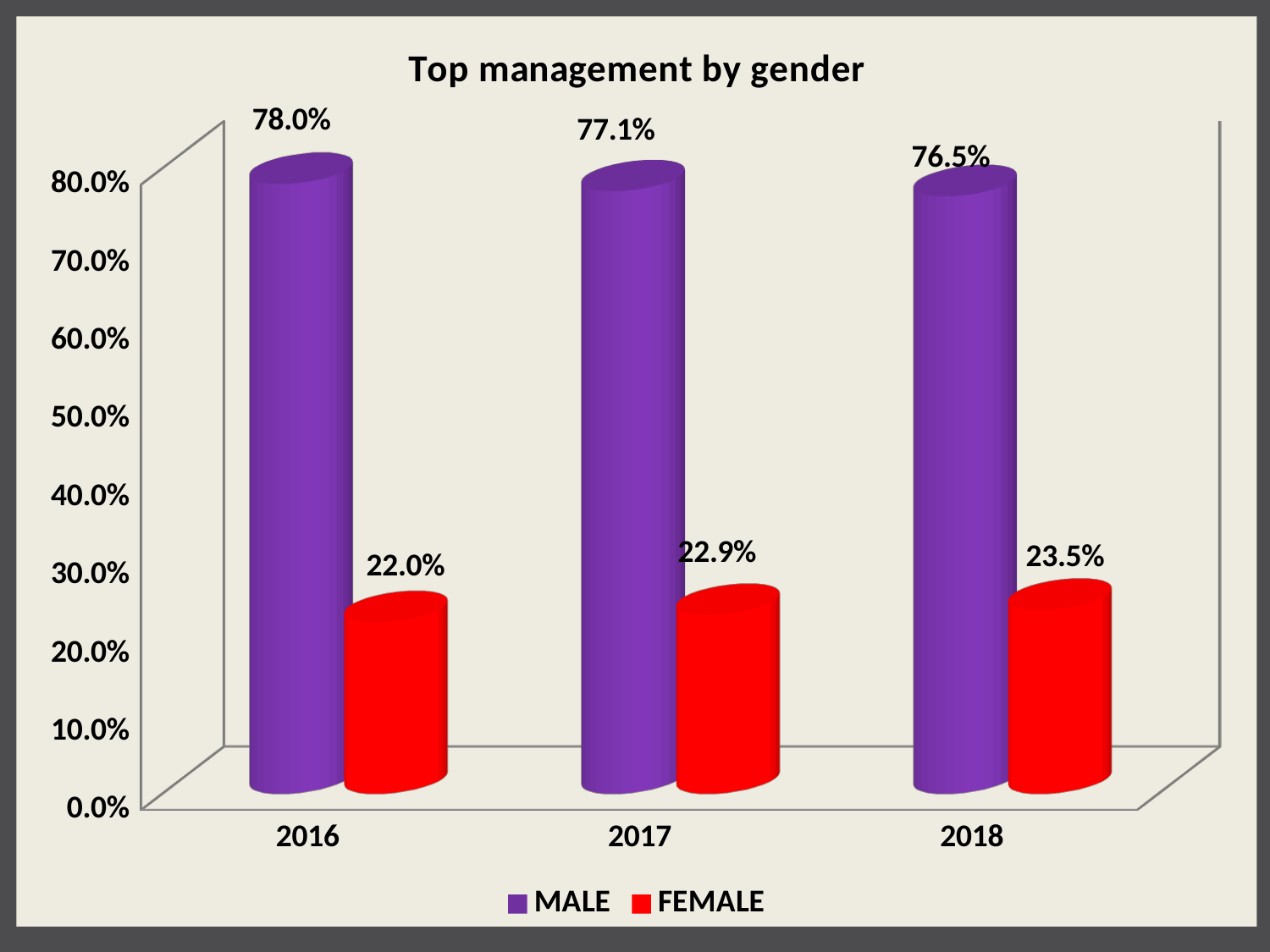
In which year is the FEMALE value highest? 2018 What is the FEMALE value for 2018? 23.5% In which year is the MALE value lowest? 2018 What is the MALE value for 2017? 77.1% Which is larger in 2018, the MALE value or the FEMALE value? MALE What is the FEMALE value for 2017? 22.9% How many years are shown on the x axis? 3 Does the MALE value rise or fall from 2016 to 2018? Fall What kind of chart is shown? Bar chart What is the MALE value for 2016? 78.0% How many series does the legend list? 2 What is the difference between the MALE and FEMALE values in 2016? 56.0%